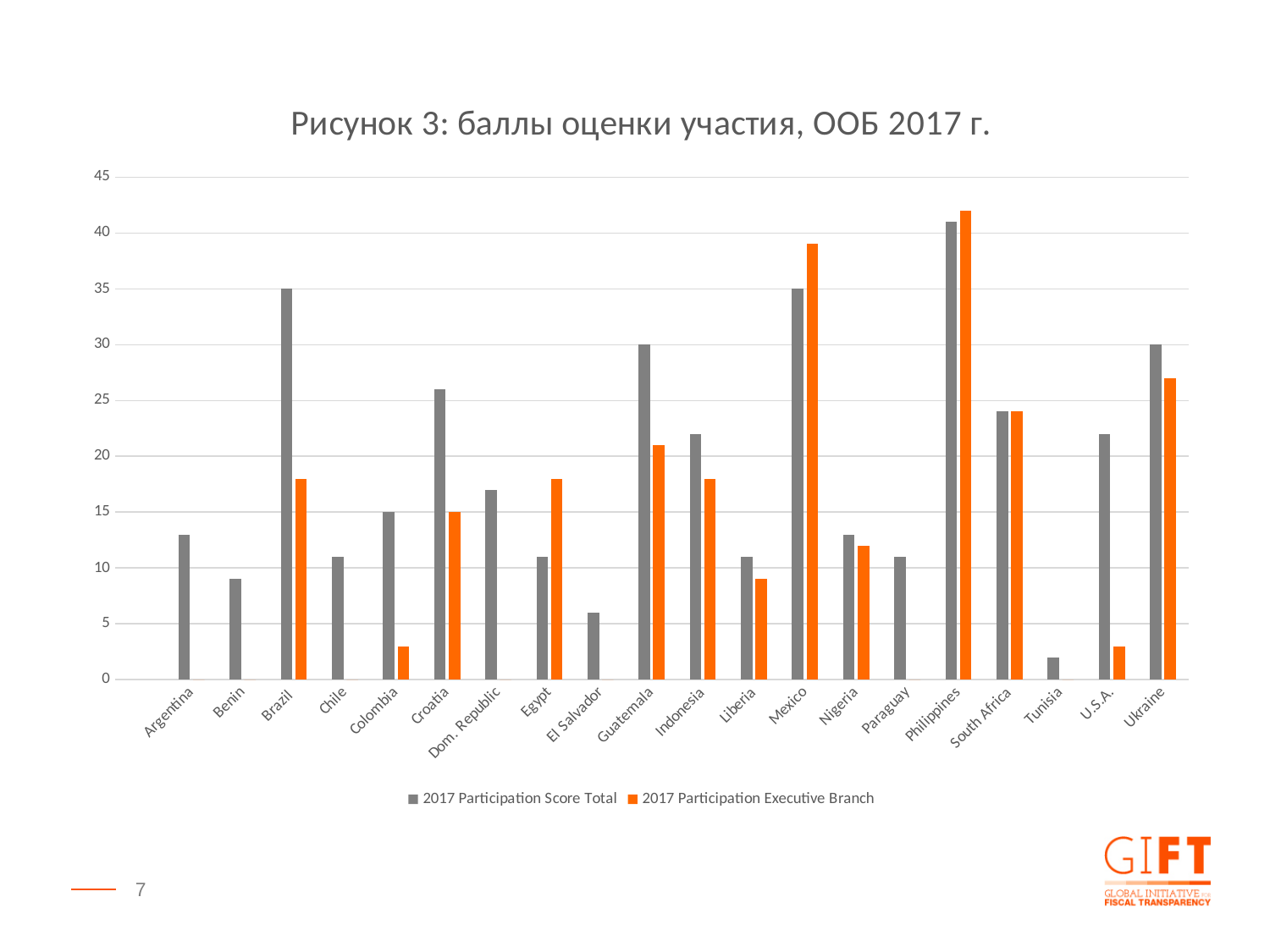
For Brazil, which is larger: the 2017 Participation Score Total or the 2017 Participation Executive Branch value? 2017 Participation Score Total How many countries are shown on the x axis? 20 Which country has the highest 2017 Participation Score Total? Philippines Is the 2017 Participation Executive Branch value for Mexico greater or less than 35? greater What is the 2017 Participation Score Total for Guatemala? 30 What is the 2017 Participation Executive Branch value for Croatia? 15 What is the 2017 Participation Score Total for Brazil? 35 Which country has the lowest 2017 Participation Score Total? Tunisia What kind of chart is shown on the slide? bar chart Is the 2017 Participation Score Total for Argentina greater or less than 15? less How many series does the legend list? 2 Which colour represents the 2017 Participation Executive Branch series? orange